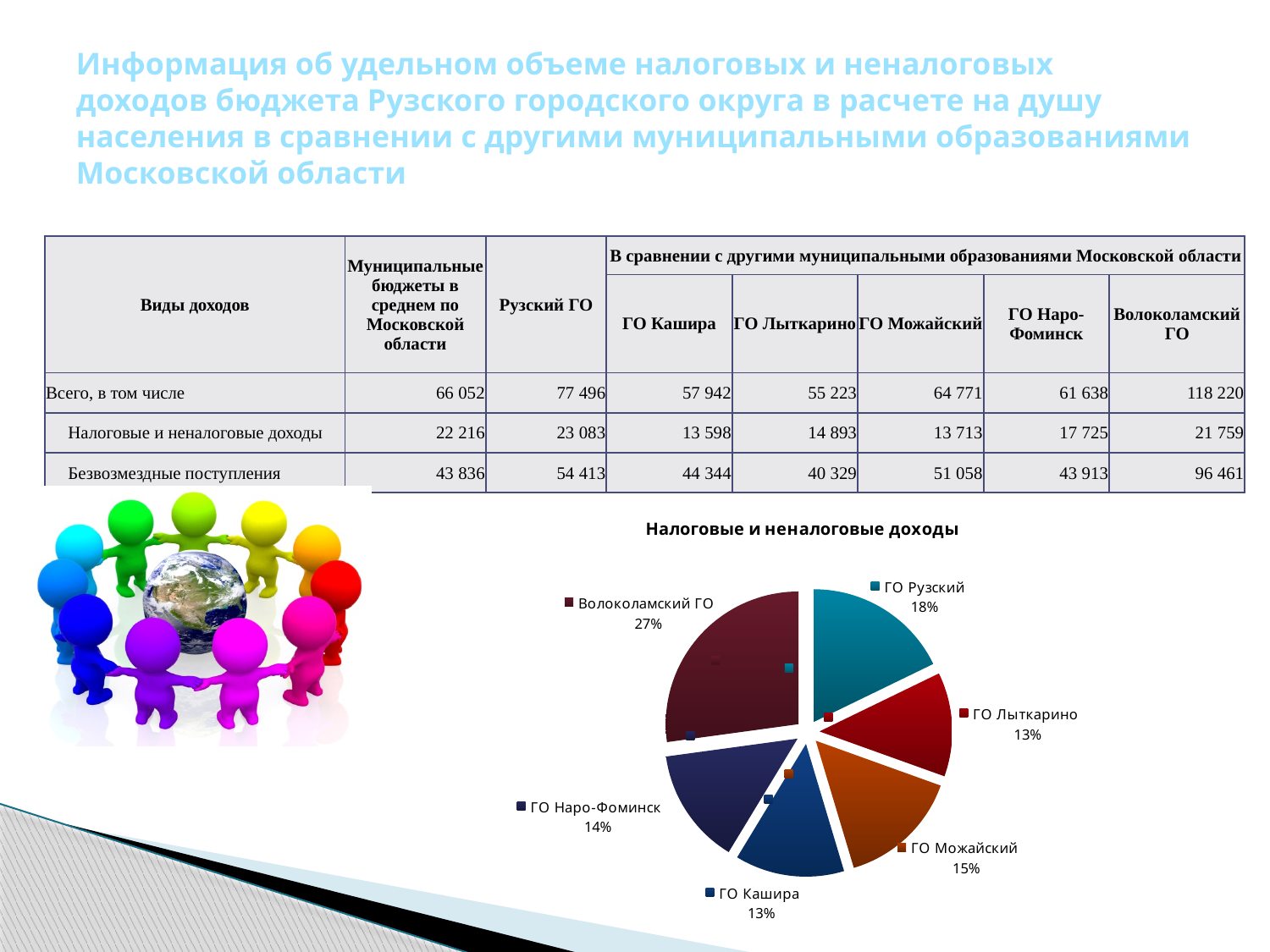
Which has a larger share in the pie chart, ГО Рузский or ГО Можайский? ГО Рузский What share of the pie does ГО Кашира have? 13% What is the title of the pie chart? Налоговые и неналоговые доходы What is the difference in percentage points between the shares of Волоколамский ГО and ГО Рузский? 9 Which two slices in the pie chart both have a share of 13%? ГО Лыткарино and ГО Кашира Which slice of the pie chart is the largest? Волоколамский ГО What kind of chart is shown on the slide? pie chart What share of the pie does ГО Наро-Фоминск have? 14% What share of the pie does Волоколамский ГО have? 27% How many slices does the pie chart have? 6